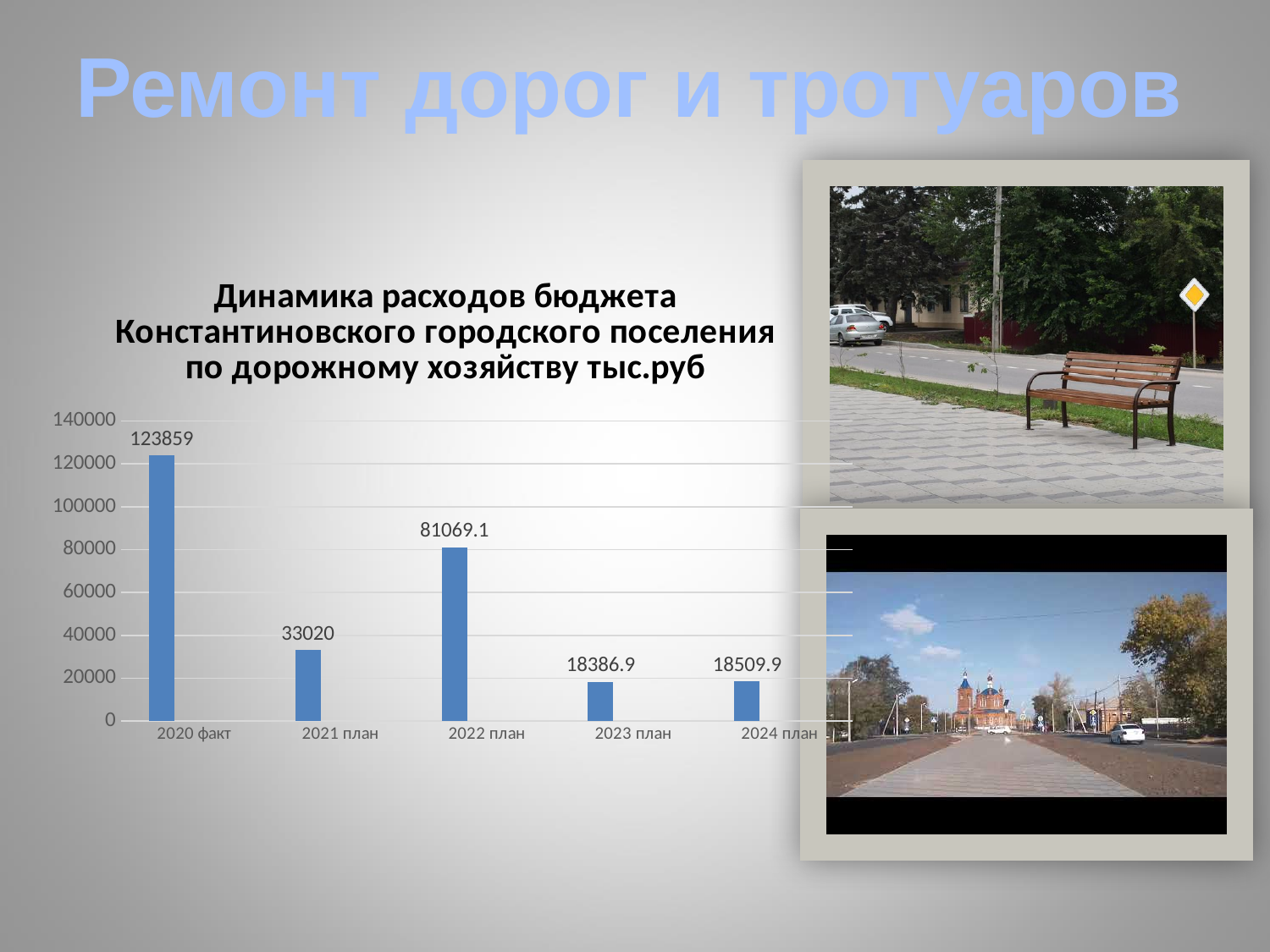
How many categories are shown on the x axis? 5 Which category has the highest value? 2020 факт What is the difference between the values for 2024 план and 2023 план? 123 Which is larger, the value for 2021 план or the value for 2022 план? 2022 план What unit is given in the chart title? тыс.руб Is the value for 2021 план greater or less than 40000? less What is the value for 2020 факт? 123859 What kind of chart is shown on the slide? bar chart What is the difference between the values for 2020 факт and 2021 план? 90839 What is the value for 2024 план? 18509.9 What is the value for 2022 план? 81069.1 Which category has the lowest value? 2023 план